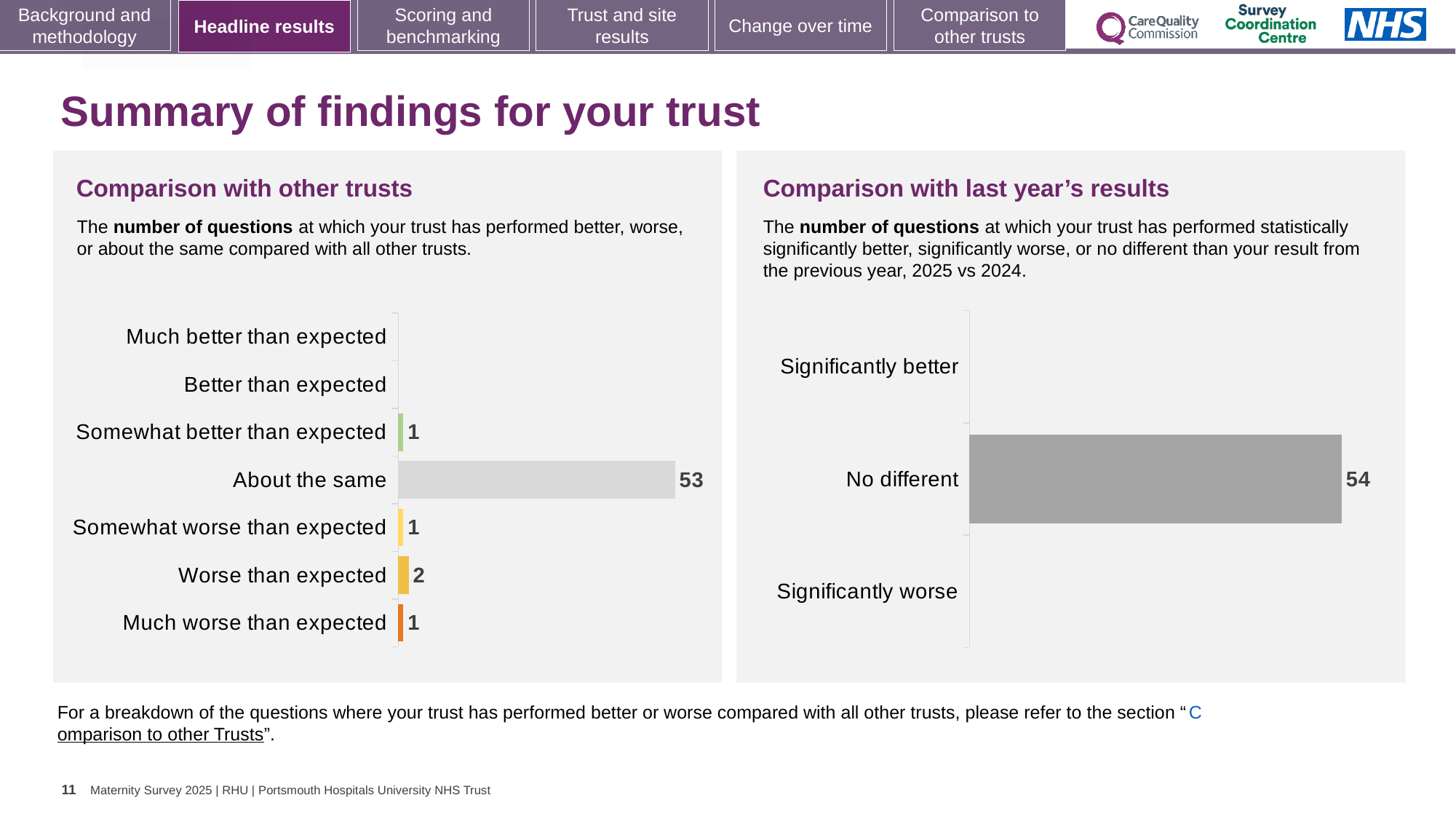
What is the title of the chart on the right side of the slide? Comparison with last year's results In the 'Comparison with other trusts' chart, what is the value for 'Worse than expected'? 2 In the 'Comparison with other trusts' chart, which category has the highest value? About the same In the 'Comparison with other trusts' chart, what is the value for 'Somewhat better than expected'? 1 In the 'Comparison with other trusts' chart, what is the difference between 'About the same' and 'Worse than expected'? 51 In the 'Comparison with last year's results' chart, which category has the highest value? No different How many categories are listed on the 'Comparison with other trusts' chart? 7 In the 'Comparison with other trusts' chart, which is larger: 'Worse than expected' or 'Much worse than expected'? Worse than expected What kind of chart is the 'Comparison with other trusts' chart? Bar chart In the 'Comparison with last year's results' chart, what is the value for 'No different'? 54 How many categories are listed on the 'Comparison with last year's results' chart? 3 In the 'Comparison with other trusts' chart, how many questions are 'About the same'? 53